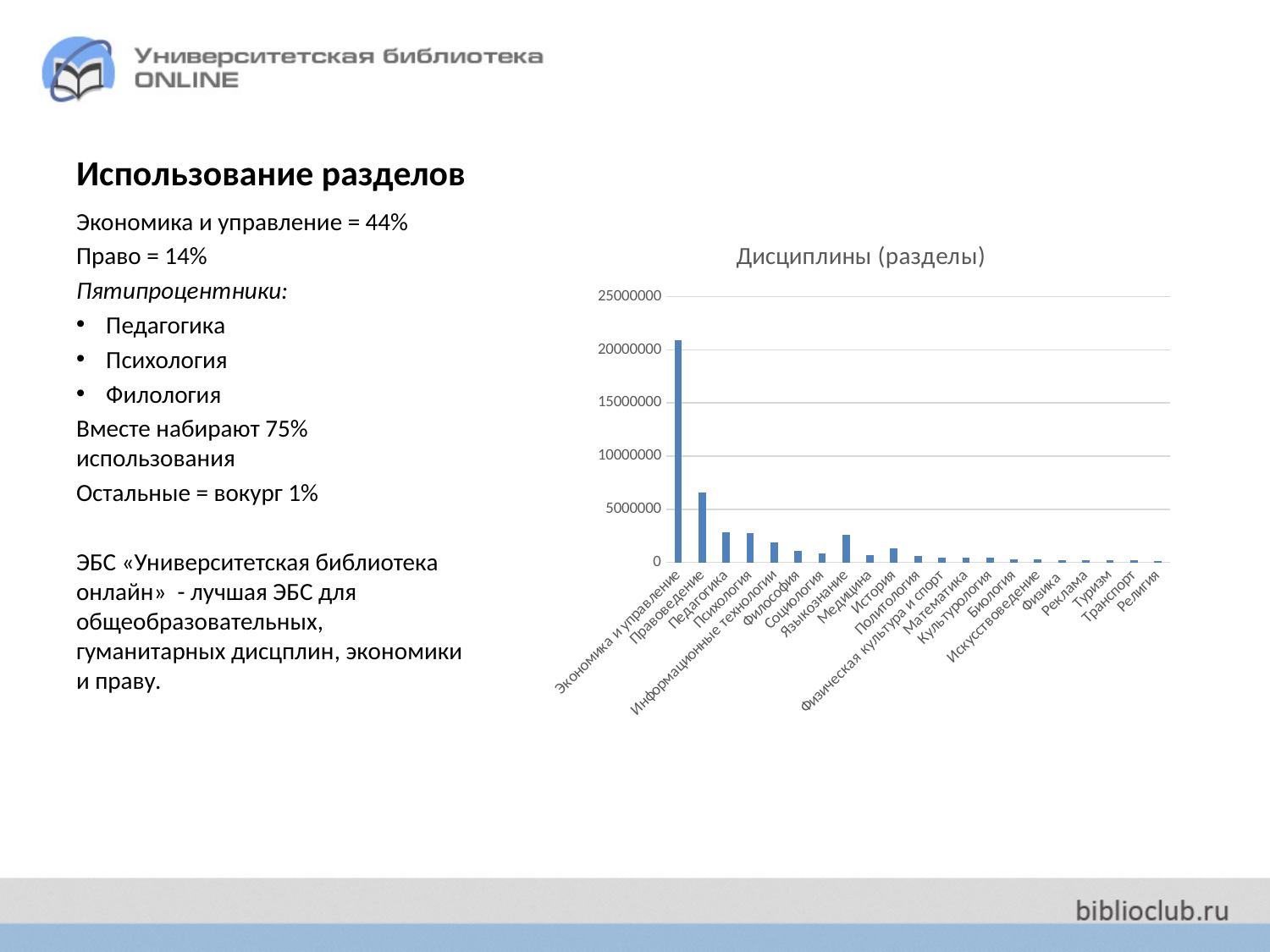
How many categories are plotted in the chart? 21 Which is larger, the value for Правоведение or the value for Педагогика? Правоведение Is the value for Языкознание greater or less than 5000000? less Is the value for Педагогика greater or less than 5000000? less What is the highest value shown on the vertical axis? 25000000 Do the values generally rise or fall moving from left to right along the x axis? fall Which category has the highest value in the chart? Экономика и управление Is the value for Экономика и управление greater or less than 15000000? greater What is the title of the chart? Дисциплины (разделы) Which is larger, the value for Языкознание or the value for Медицина? Языкознание What kind of chart is shown on the slide? bar chart